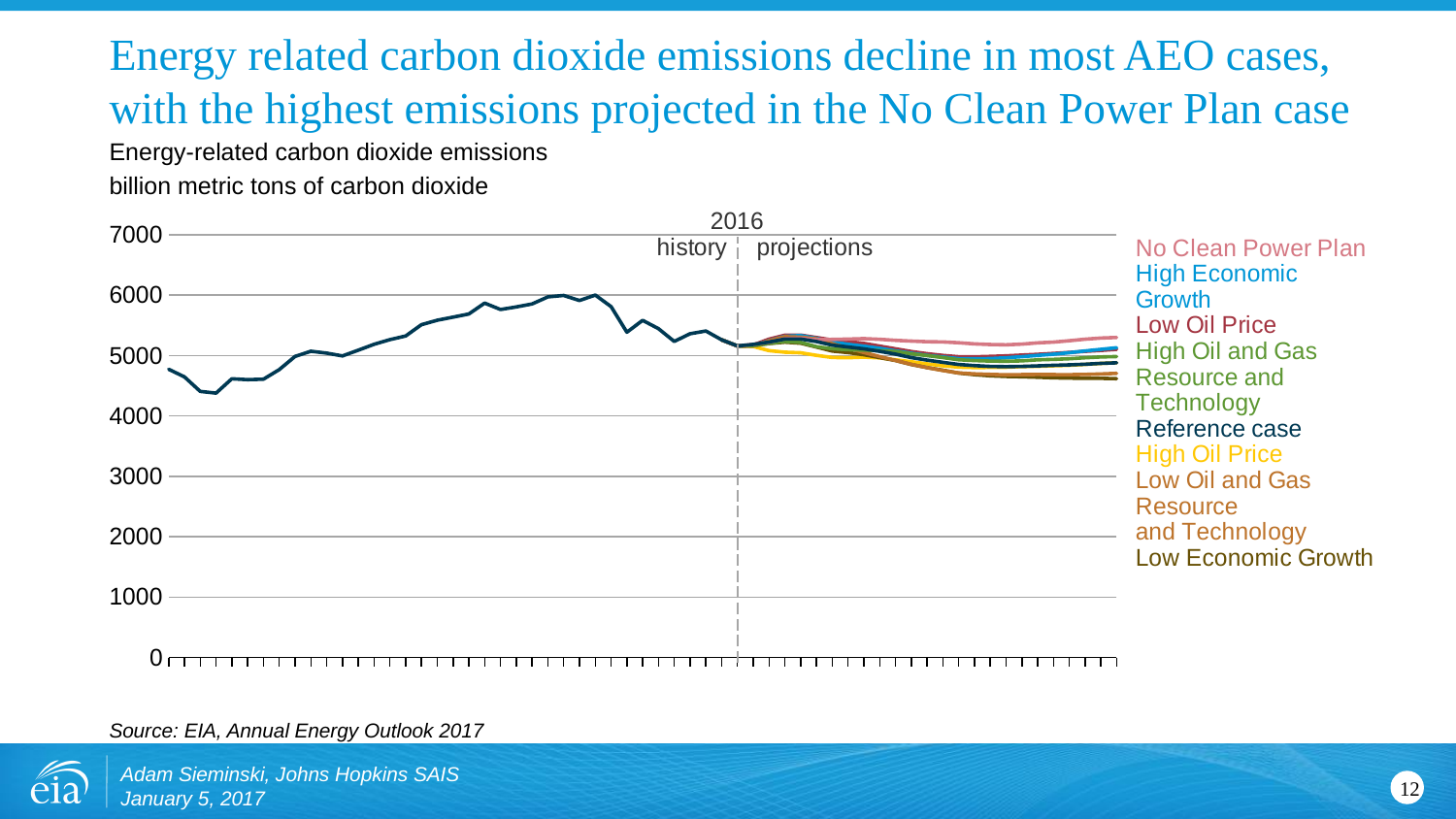
Is the projected value for the No Clean Power Plan case at the end of the projection period greater or less than 5000? greater What year separates history from projections on the chart? 2016 Is the projected value for the Low Economic Growth case at the end of the projection period greater or less than 5000? less How many cases (series) does the legend list? 8 What kind of chart is shown on the slide? line chart Is the peak value of the history line greater or less than 7000? less Which case has the lowest projected emissions at the end of the projection period? Low Economic Growth What unit is used on the chart's y axis? billion metric tons of carbon dioxide Which is larger at the end of the projection period: the No Clean Power Plan case or the Low Economic Growth case? No Clean Power Plan Which case has the highest projected emissions at the end of the projection period? No Clean Power Plan Do the projected emissions for the Low Economic Growth case rise or fall over the projection period? fall